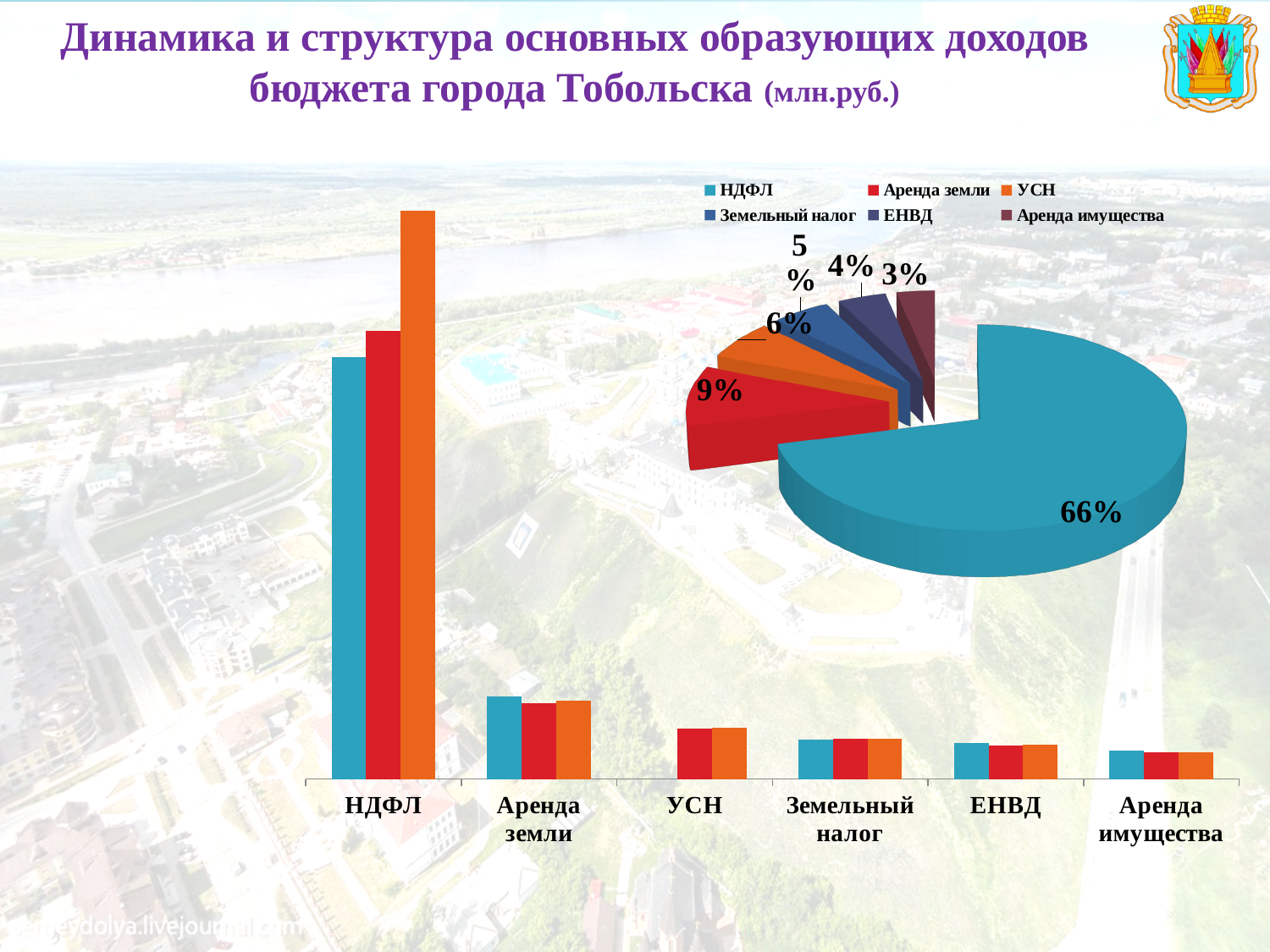
In the pie chart, which category has the largest slice? НДФЛ What kind of chart is the chart on the left side of the slide? bar chart In the bar chart on the left, how many categories are shown on the x axis? 6 In the pie chart, what share does Аренда имущества have? 3% In the pie chart, what is the difference in percentage points between the НДФЛ slice and the Аренда земли slice? 57 In the pie chart, what share does УСН have? 6% In the bar chart on the left, do the bar heights generally rise or fall from left to right along the x axis? fall In the pie chart, what share does НДФЛ have? 66% In the pie chart, which category has the smallest slice? Аренда имущества In the pie chart, how many entries does the legend list? 6 In the bar chart on the left, which category has the tallest bars? НДФЛ